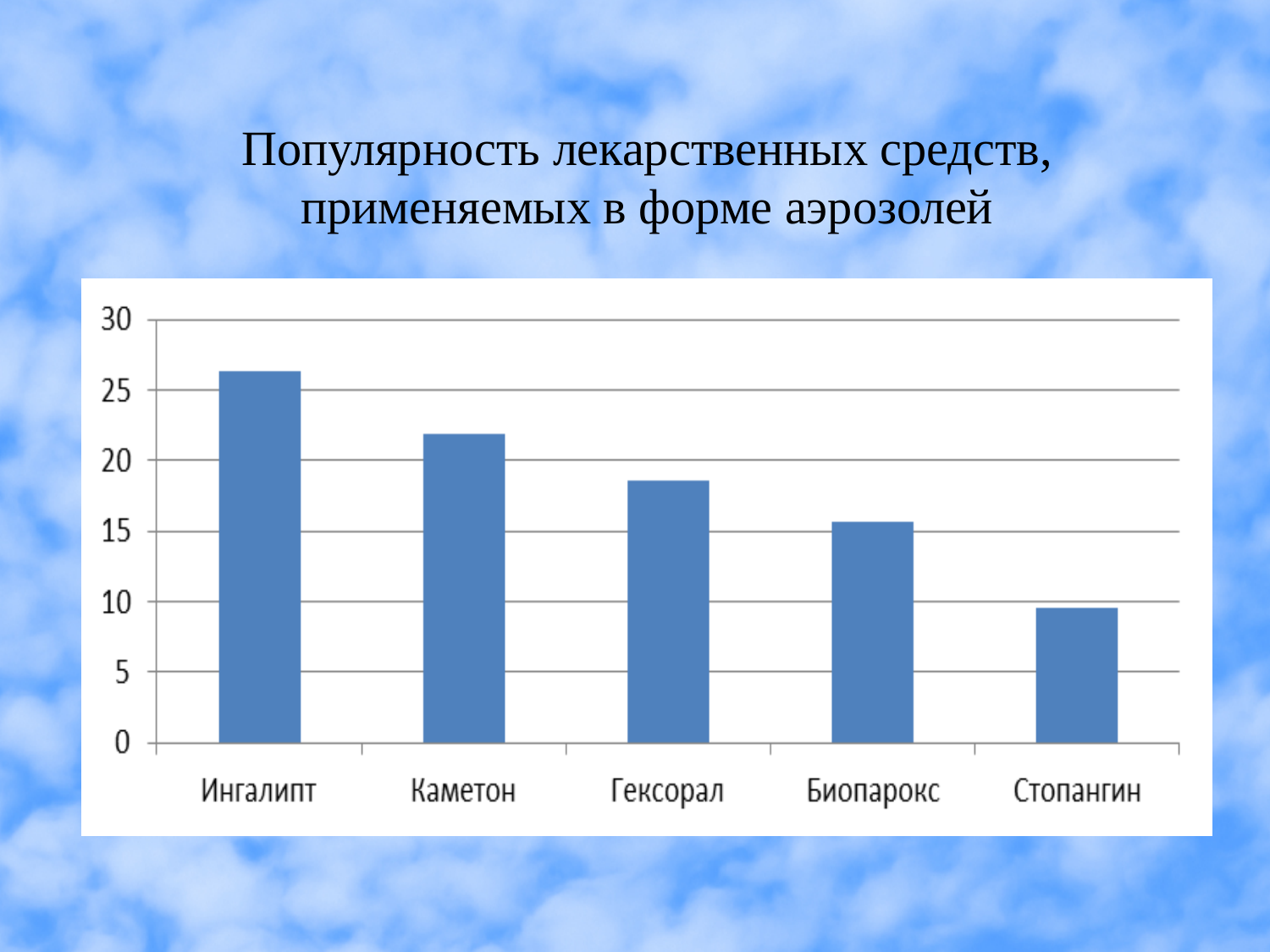
Which is larger, the value for Каметон or the value for Биопарокс? Каметон Is the value for Ингалипт greater or less than 25? greater Is the value for Стопангин greater or less than 10? less Is the value for Биопарокс greater or less than 15? greater Which drug has the highest bar in the chart? Ингалипт What is the title of the slide containing the chart? Популярность лекарственных средств, применяемых в форме аэрозолей Do the bar values rise or fall from left to right across the x axis? fall Which drug has the lowest bar in the chart? Стопангин What kind of chart is shown on the slide? bar chart How many categories (drugs) are shown on the x axis of the chart? 5